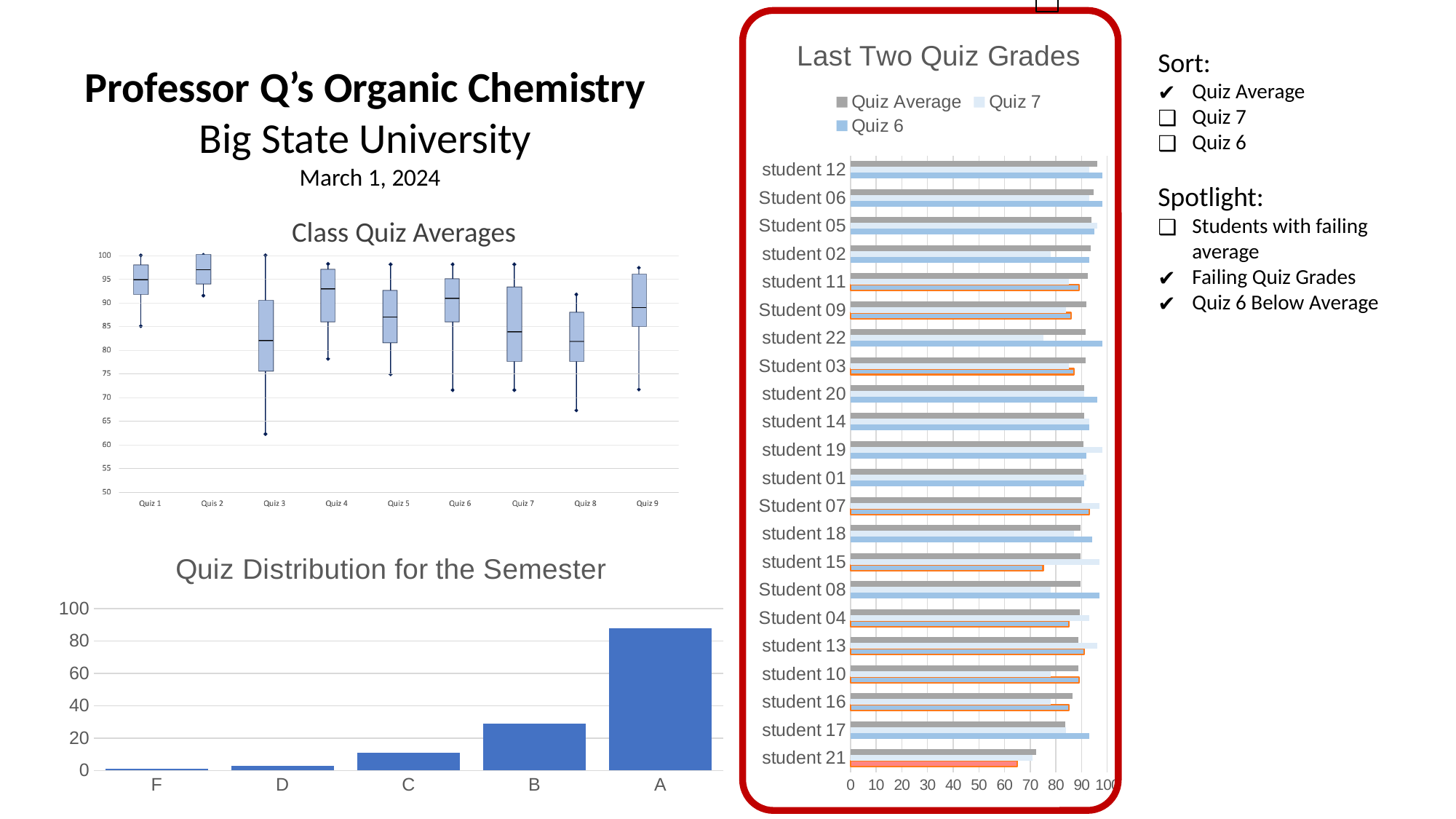
In the Quiz Distribution for the Semester chart, which grade category has the lowest value? F In the Quiz Distribution for the Semester chart, which grade category has the highest value? A In the Last Two Quiz Grades chart, which student has the lowest Quiz Average? student 21 In the Quiz Distribution for the Semester chart, is the value for D greater or less than 20? less What kind of chart is the Quiz Distribution for the Semester chart? bar chart In the Quiz Distribution for the Semester chart, is the value for A greater or less than 80? greater How many series does the legend of the Last Two Quiz Grades chart list? 3 In the Last Two Quiz Grades chart, is the Quiz 6 value for student 21 greater or less than 70? less In the Quiz Distribution for the Semester chart, do the values rise or fall moving from F to A along the x axis? rise In the Quiz Distribution for the Semester chart, how many grade categories are shown on the x axis? 5 How many quizzes are shown on the x axis of the Class Quiz Averages chart? 9